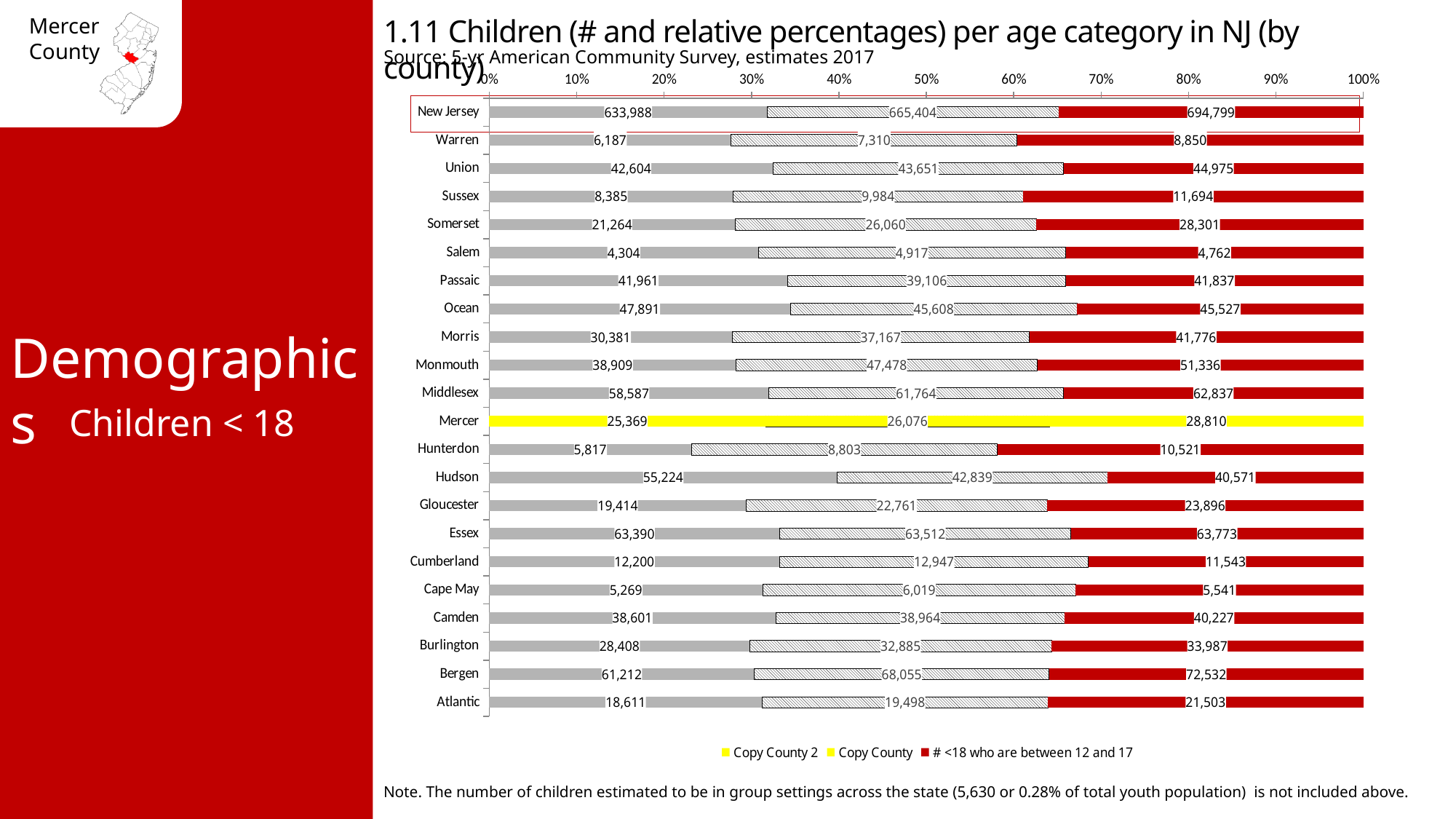
Excluding the New Jersey total row, which county has the highest value on the red segment (# <18 who are between 12 and 17)? Bergen (72,532) What is the total of the three values printed on the Mercer bar (25,369, 26,076 and 28,810)? 80,255 What kind of chart is shown on the slide? Stacked horizontal bar chart What value is printed on the middle (hatched) segment for Hudson? 42,839 For Hudson, which is larger: the value on the first (grey) segment or the value on the red segment? The first (grey) segment, 55,224 What value is printed on the red segment (# <18 who are between 12 and 17) for Mercer? 28,810 What value is printed on the first (grey) segment of the New Jersey bar? 633,988 For Mercer, what is the difference between the value on the red segment (28,810) and the value on the first segment (25,369)? 3,441 How many rows (New Jersey plus counties) are plotted in the chart? 22 What value is printed on the red segment (# <18 who are between 12 and 17) for Bergen? 72,532 Which row of the chart is highlighted in yellow? Mercer How many entries does the chart legend list? 3